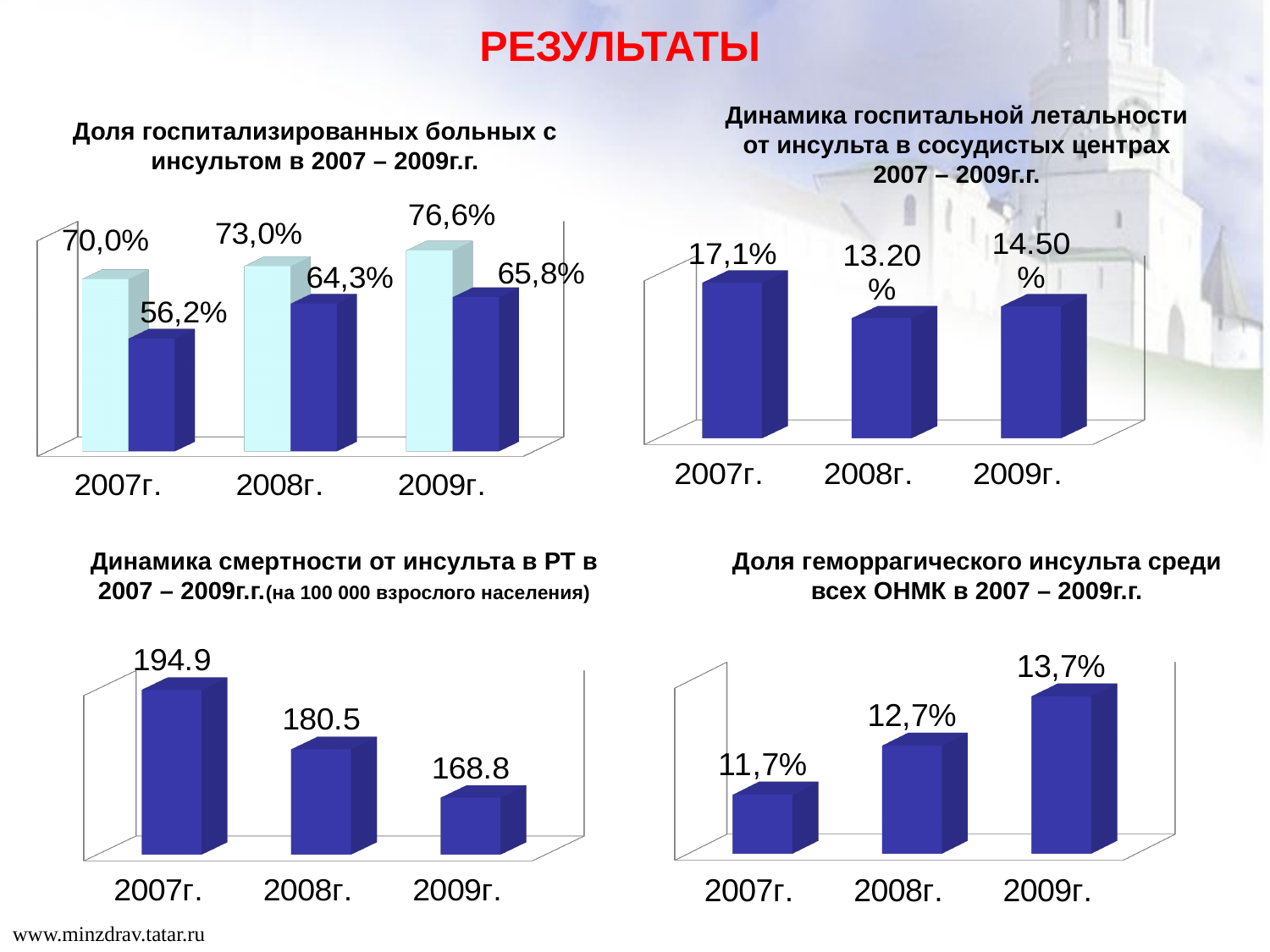
In the chart 'Доля геморрагического инсульта среди всех ОНМК в 2007 – 2009г.г.' (bottom right), what is the difference between the 2009г. and 2007г. values? 2,0% In the chart 'Динамика смертности от инсульта в РТ в 2007 – 2009г.г.' (bottom left), what is the value for 2007г.? 194.9 In the chart 'Доля госпитализированных больных с инсультом в 2007 – 2009г.г.' (top left), what is the value of the light blue bar for 2009г.? 76,6% In the chart 'Доля геморрагического инсульта среди всех ОНМК в 2007 – 2009г.г.' (bottom right), do the values rise or fall from 2007г. to 2009г.? rise In the chart 'Доля геморрагического инсульта среди всех ОНМК в 2007 – 2009г.г.' (bottom right), what is the value for 2008г.? 12,7% In the chart 'Динамика госпитальной летальности от инсульта в сосудистых центрах 2007 – 2009г.г.' (top right), what is the value for 2009г.? 14.50% How many years are shown on the x axis of the chart 'Динамика смертности от инсульта в РТ в 2007 – 2009г.г.' (bottom left)? 3 In the chart 'Динамика смертности от инсульта в РТ в 2007 – 2009г.г.' (bottom left), which year has the lowest value? 2009г. What kind of chart is 'Доля геморрагического инсульта среди всех ОНМК в 2007 – 2009г.г.' (bottom right)? bar chart In the chart 'Динамика смертности от инсульта в РТ в 2007 – 2009г.г.' (bottom left), what is the difference between the 2007г. and 2009г. values? 26.1 In the chart 'Динамика госпитальной летальности от инсульта в сосудистых центрах 2007 – 2009г.г.' (top right), which year has the highest value? 2007г. In the chart 'Динамика госпитальной летальности от инсульта в сосудистых центрах 2007 – 2009г.г.' (top right), which is larger, the value for 2008г. or 2009г.? 2009г.